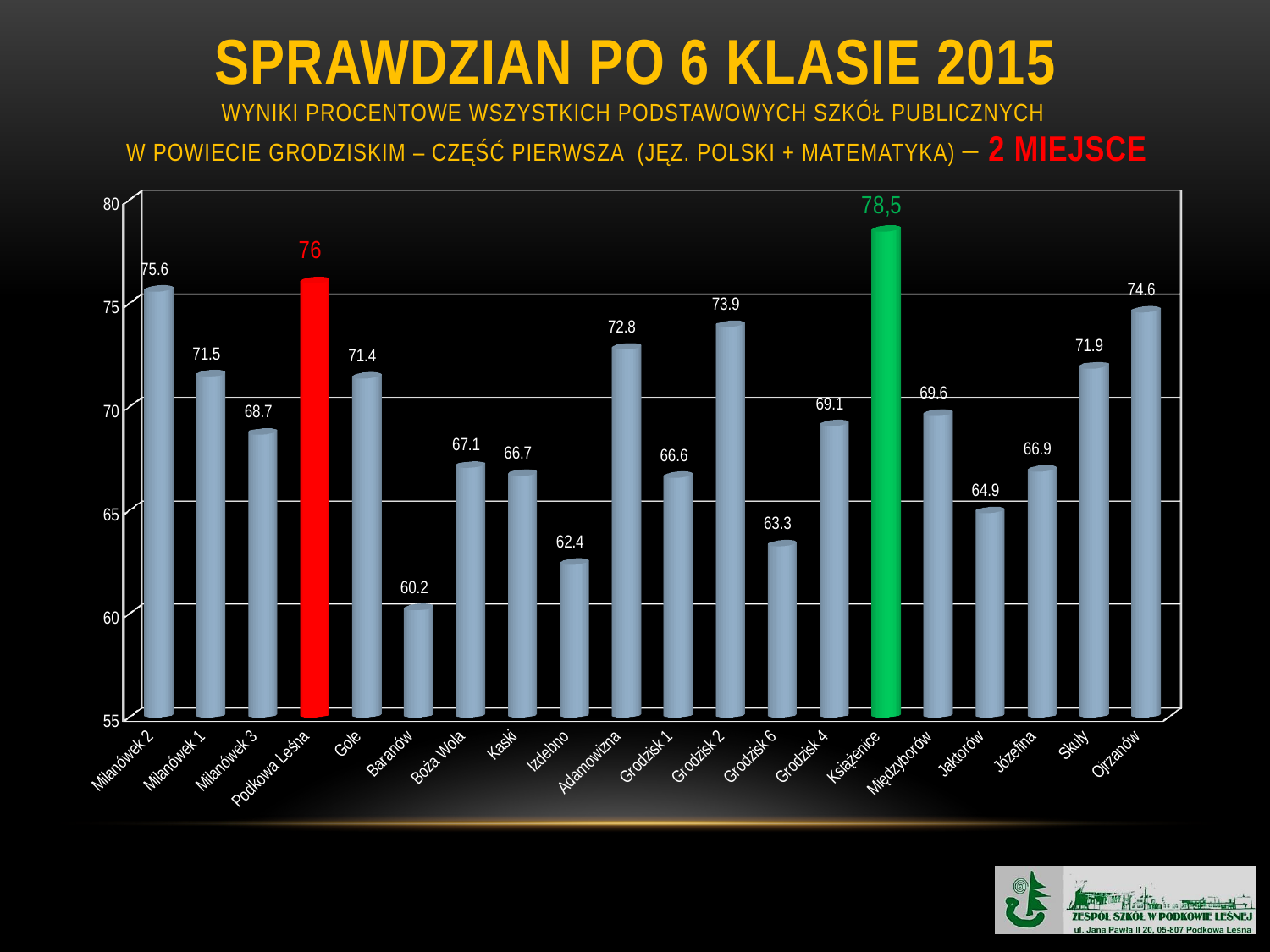
What is the value for Podkowa Leśna? 76 Is the value for Izdebno greater or less than 65? less What is the value for Grodzisk 2? 73.9 Which school has the lowest value? Baranów What is the value for Jaktorów? 64.9 Which school's bar is coloured red? Podkowa Leśna What is the difference between the values for Milanówek 2 and Milanówek 1? 4.1 What is the difference between the values for Książenice and Podkowa Leśna? 2.5 What kind of chart is shown on the slide? bar chart How many schools are shown on the x axis? 20 Which is larger, the value for Adamowizna or the value for Grodzisk 2? Grodzisk 2 Which school has the highest value? Książenice